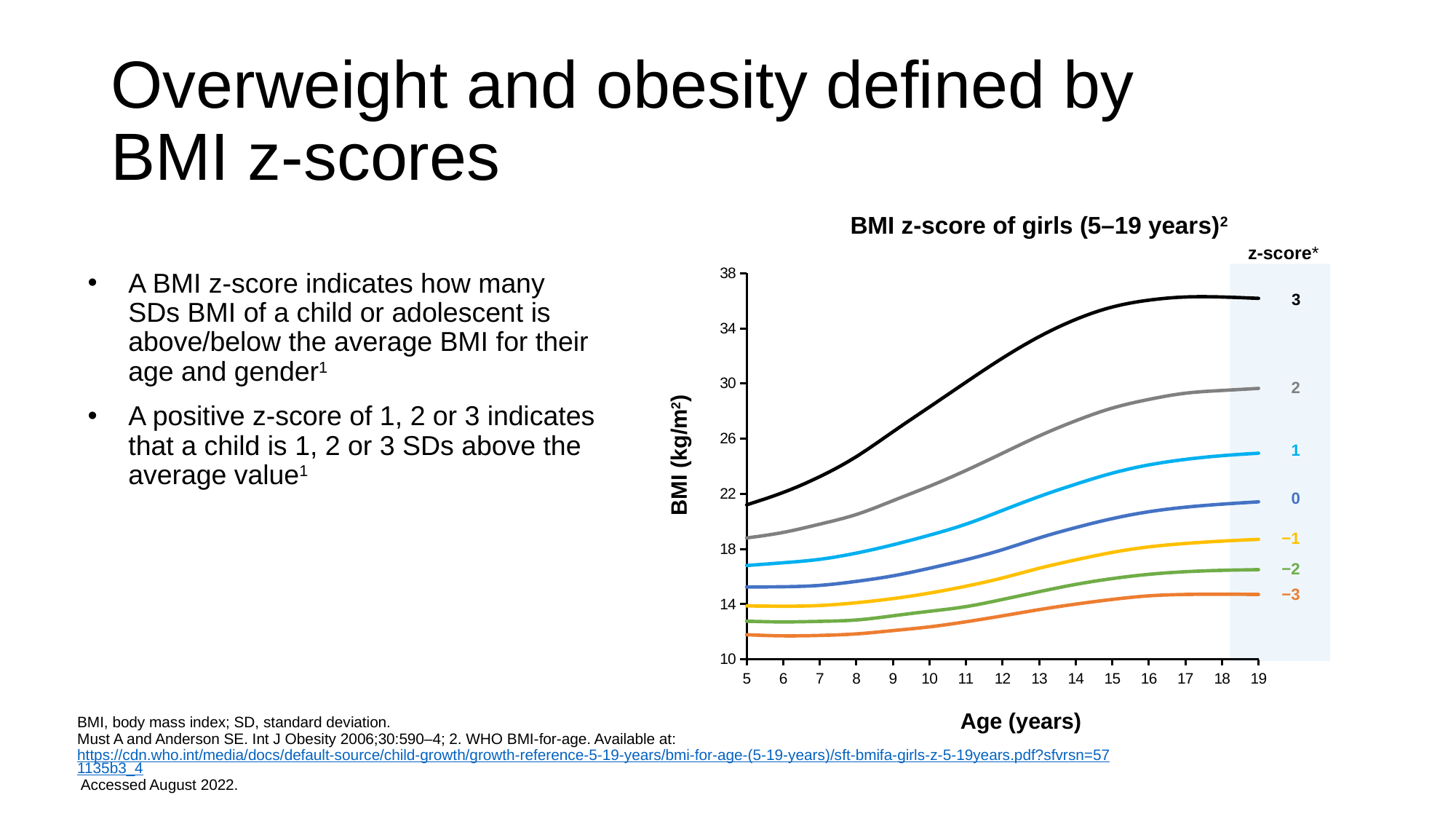
At age 12, which line has the higher BMI value: z-score 3 or z-score 2? z-score 3 Which z-score line has the lowest BMI values across all ages? −3 Does the BMI value for the z-score 3 line rise or fall from age 5 to age 17? rise Which z-score line has the highest BMI values across all ages? 3 Is the BMI value for the z-score 3 line at age 19 greater or less than 34? greater How many age values are marked on the x axis of the chart? 15 What is the title of the chart? BMI z-score of girls (5–19 years) Is the BMI value for the z-score 1 line at age 19 greater or less than 22? greater What kind of chart is shown on the slide? line chart What is the label of the y axis of the chart? BMI (kg/m²) How many z-score lines are plotted on the chart? 7 Is the BMI value for the z-score −3 line at age 5 greater or less than 14? less